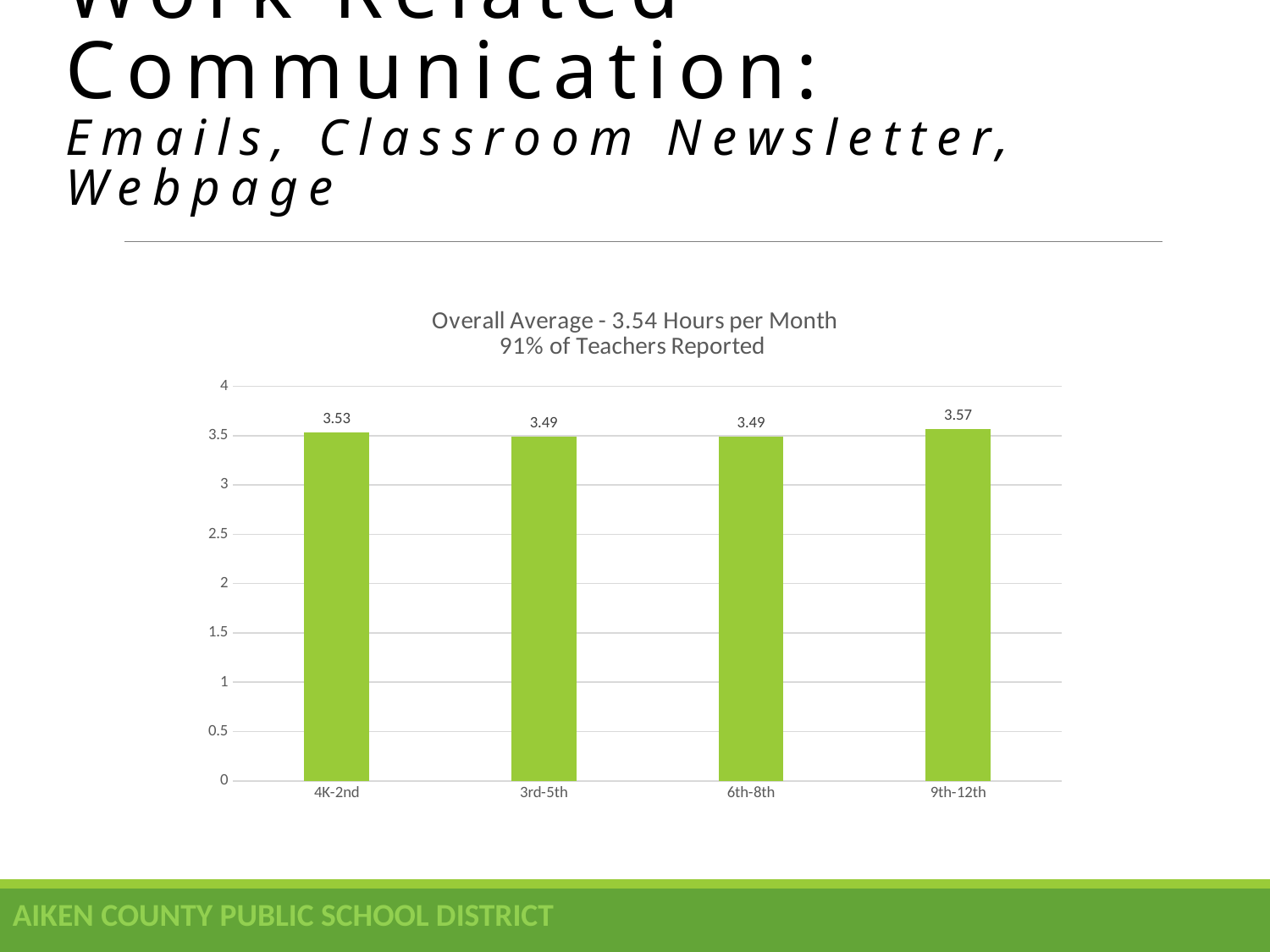
What is the difference between the values for 9th-12th and 3rd-5th? 0.08 What is the value for 3rd-5th? 3.49 What is the value for 6th-8th? 3.49 What is the value for 4K-2nd? 3.53 Is the value for 3rd-5th greater or less than 3? greater What is the lowest value shown on the chart? 3.49 What kind of chart is shown on the slide? bar chart How many categories are shown on the x axis? 4 What is the value for 9th-12th? 3.57 Which is larger, the value for 4K-2nd or the value for 6th-8th? 4K-2nd What is the difference between the values for 9th-12th and 4K-2nd? 0.04 Which category has the highest value? 9th-12th